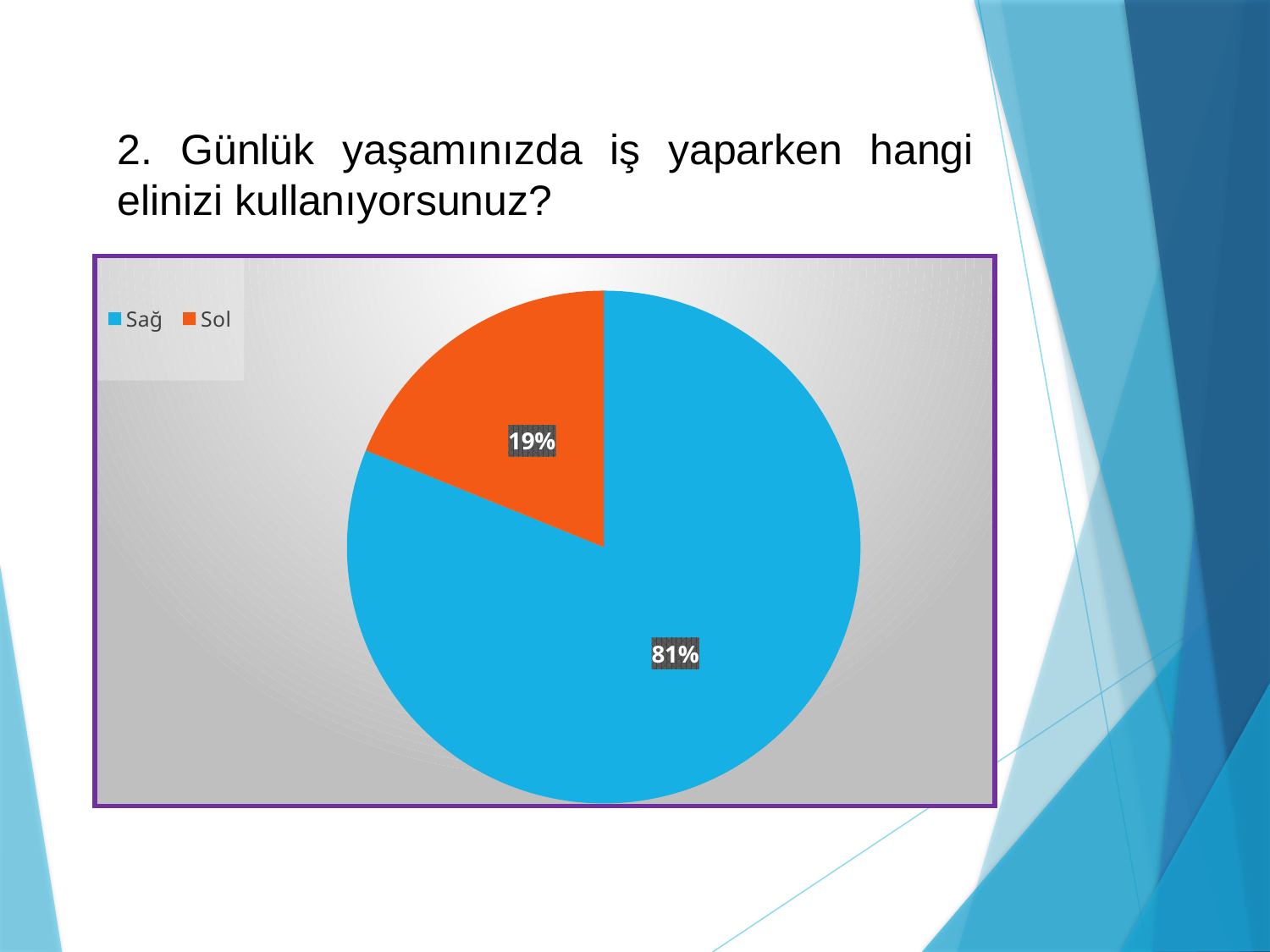
Which category has the smallest slice of the pie? Sol What kind of chart is shown on the slide? pie chart What share of the pie does Sol represent? 19% What colour is the Sol slice? orange What share of the pie does Sağ represent? 81% What is the difference in percentage points between the Sağ and Sol slices? 62 How many slices does the pie chart have? 2 Which category has the largest slice of the pie? Sağ Which is larger, the Sağ slice or the Sol slice? Sağ How many entries does the legend list? 2 What colour is the Sağ slice? blue